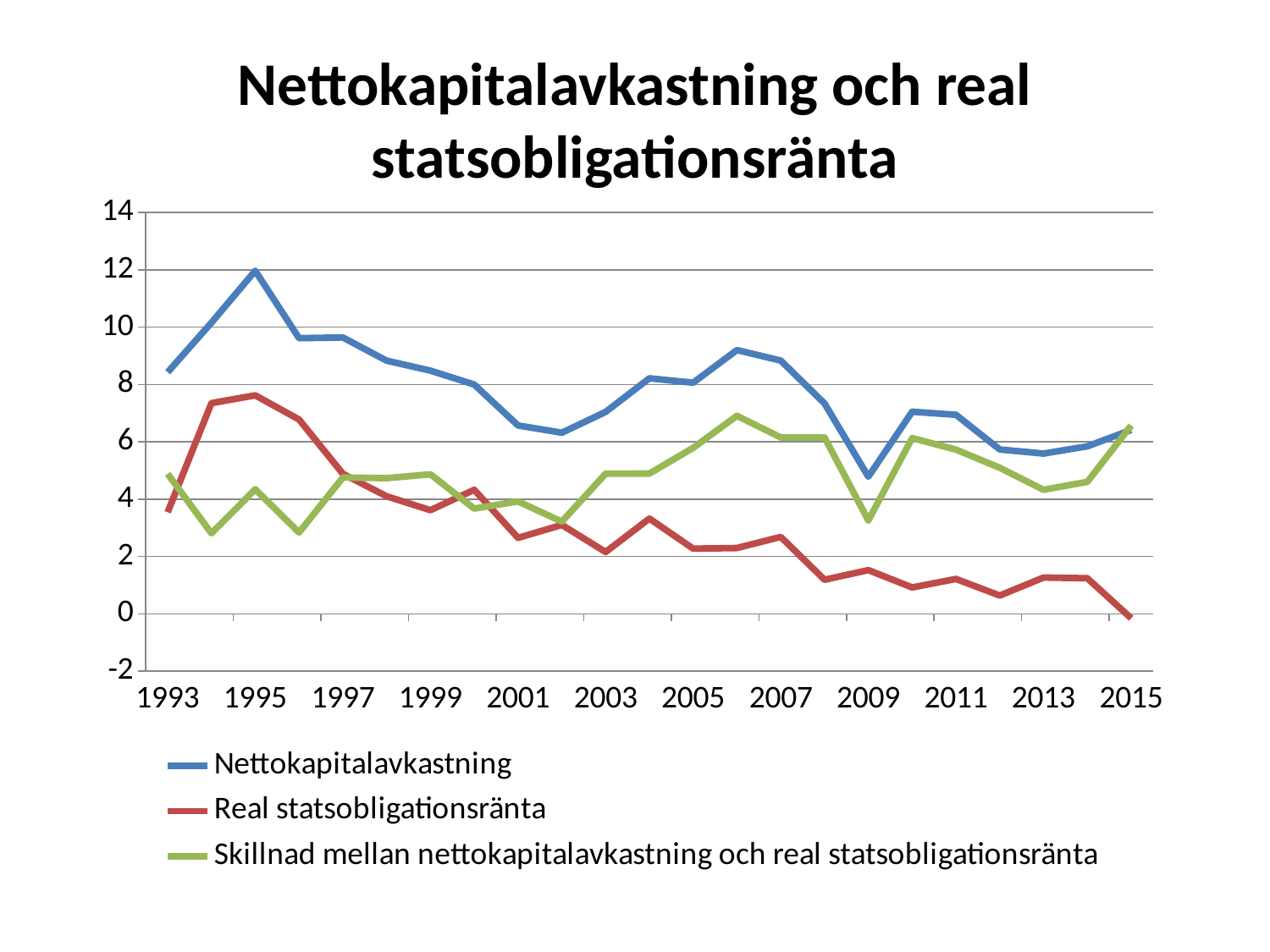
In which year is Real statsobligationsränta at its lowest? 2015 In which year does Nettokapitalavkastning reach its highest value? 1995 How many series does the legend list? 3 Does Real statsobligationsränta overall rise or fall between 1993 and 2015? fall Is the value for Nettokapitalavkastning in 2009 greater or less than 6? less How many years (data points) does each line cover, from 1993 to 2015? 23 What colour is the line for Real statsobligationsränta? red Which is larger: Nettokapitalavkastning in 2009 or in 2010? 2010 In which year does Real statsobligationsränta reach its highest value? 1995 Is the value for Nettokapitalavkastning in 1995 greater or less than 10? greater Is the value for Real statsobligationsränta in 2015 greater or less than 2? less What type of chart is shown on the slide? line chart